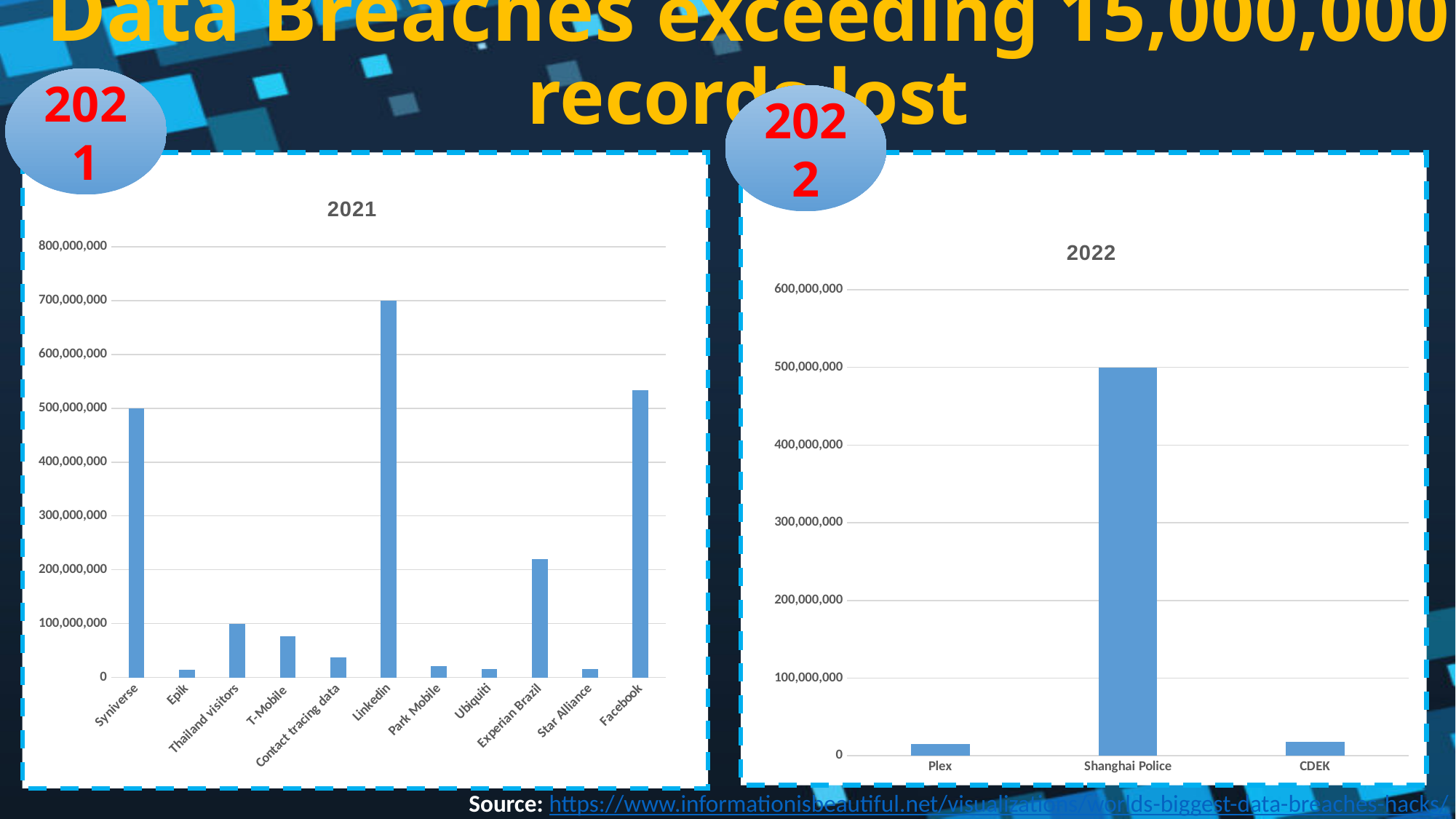
In the 2021 chart, which is larger, Experian Brazil or T-Mobile? Experian Brazil In the 2021 chart, is the value for T-Mobile greater or less than 100,000,000? less In the 2022 chart, which breach has the highest number of records lost? Shanghai Police What is the title of the chart on the right? 2022 How many breaches are shown in the 2021 chart? 11 In the 2022 chart, what is the value for Shanghai Police? 500,000,000 In the 2021 chart, which breach has the highest number of records lost? Linkedin What type of chart is the 2021 chart on the left? bar chart In the 2021 chart, is the value for Facebook greater or less than 500,000,000? greater In the 2021 chart, what is the value for Linkedin? 700,000,000 How many breaches are shown in the 2022 chart? 3 In the 2022 chart, which breach has the lowest number of records lost? Plex